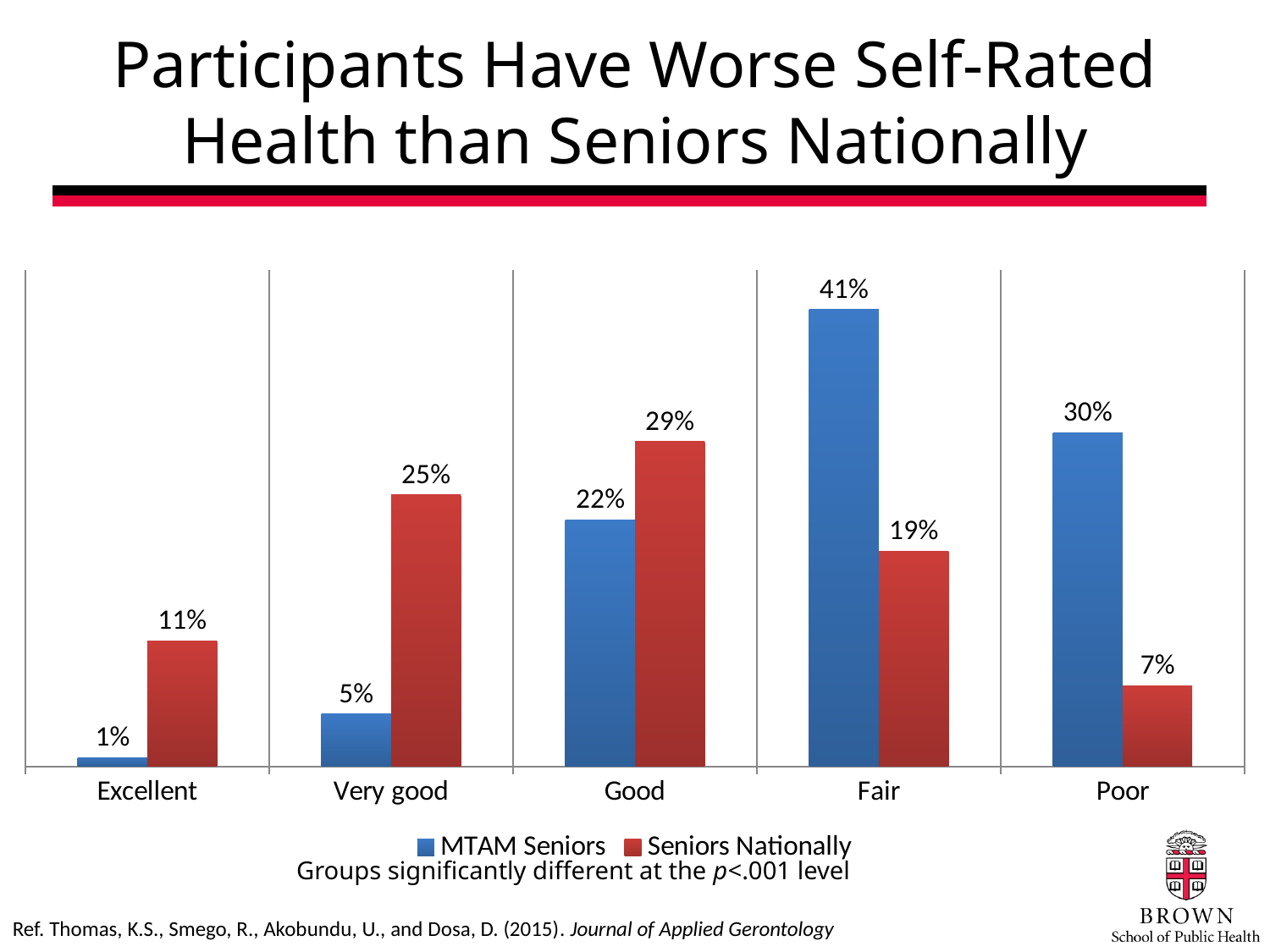
What percentage of Seniors Nationally rated their health as Very good? 25% How many health rating categories are shown on the x axis? 5 In the Very good category, which group has the larger value, MTAM Seniors or Seniors Nationally? Seniors Nationally What is the difference between Seniors Nationally and MTAM Seniors in the Good category? 7% Which colour represents Seniors Nationally in the chart? Red What percentage of MTAM Seniors rated their health as Excellent? 1% What kind of chart is shown on the slide? Bar chart Which health rating category has the lowest value for Seniors Nationally? Poor How many series does the legend list? 2 What percentage of MTAM Seniors rated their health as Fair? 41% What is the difference between MTAM Seniors and Seniors Nationally in the Poor category? 23% Which health rating category has the highest value for MTAM Seniors? Fair